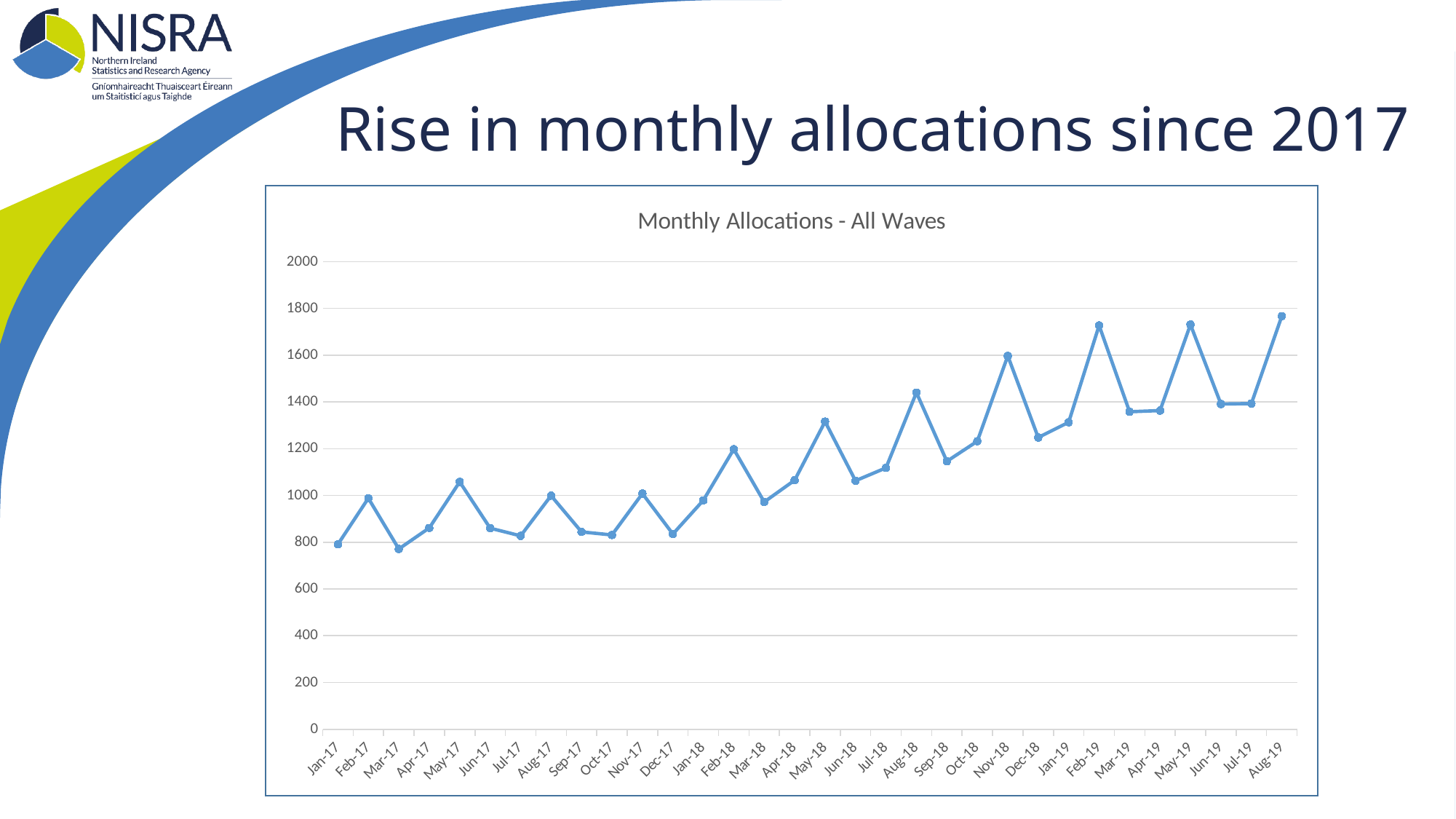
Is the value for Aug-19 greater or less than 1600? greater Which month has the highest monthly allocation on the chart? Aug-19 Is the value for Jan-17 greater or less than 1000? less What kind of chart is shown on the slide? line chart Is the value for Nov-18 greater or less than 1400? greater What is the highest value shown on the vertical axis? 2000 Which is larger, the value for May-17 or the value for Jul-17? May-17 Overall, do the monthly allocations rise or fall from Jan-17 to Aug-19? rise Which is larger, the value for Feb-19 or the value for Feb-18? Feb-19 How many monthly data points are plotted on the chart? 32 What is the title of the chart? Monthly Allocations - All Waves